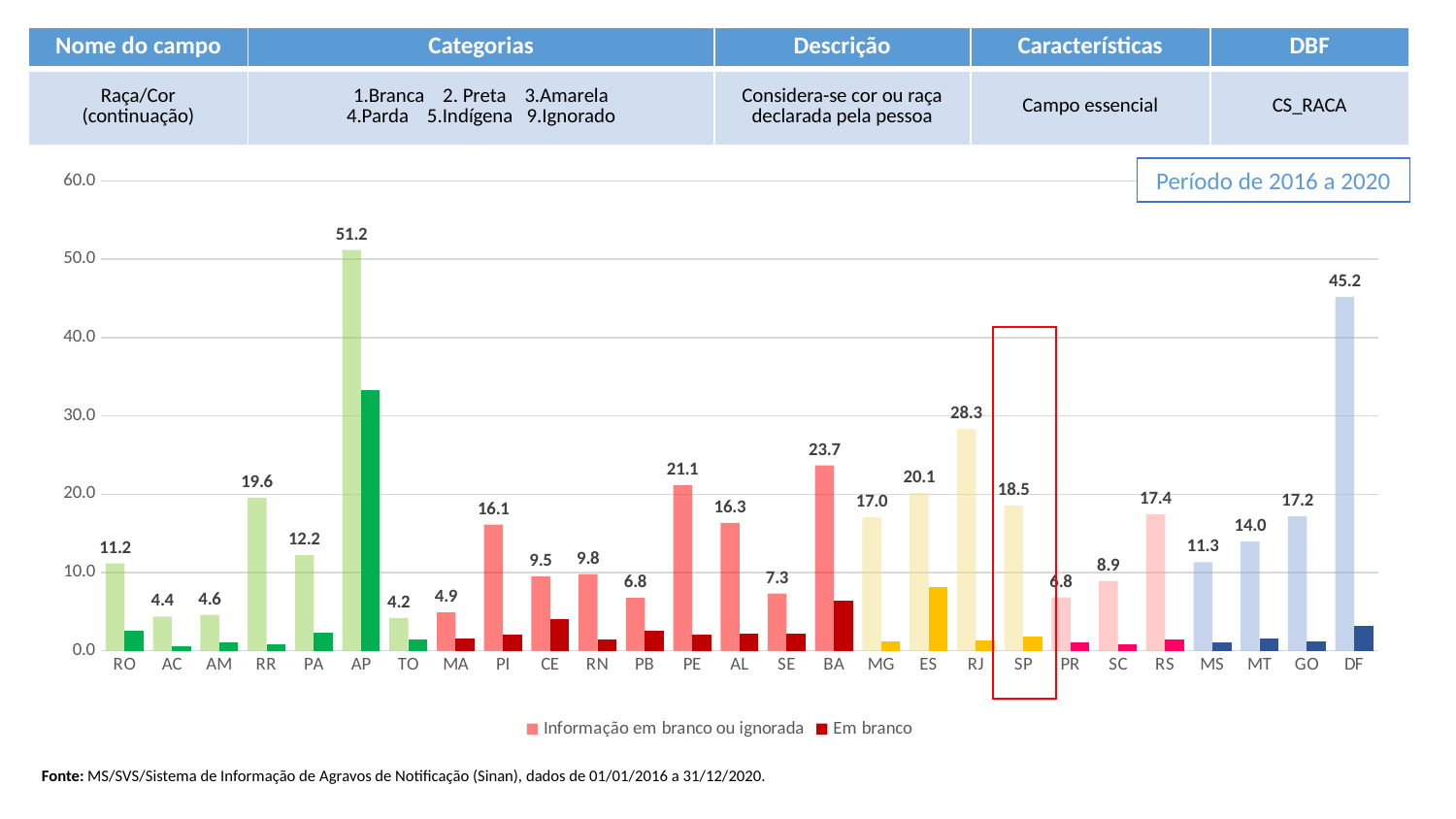
How many states are shown on the x axis of the chart? 27 Which has a larger "Informação em branco ou ignorada" value, BA or PE? BA What is the value of "Informação em branco ou ignorada" for AP? 51.2 What period does the chart cover, according to the box in the top right? Período de 2016 a 2020 What type of chart is shown on the slide? Bar chart What is the value of "Informação em branco ou ignorada" for DF? 45.2 What is the value of "Informação em branco ou ignorada" for SP? 18.5 What is the difference between the "Informação em branco ou ignorada" values for RJ and SP? 9.8 How many series does the chart legend list? 2 Which state has the lowest value for "Informação em branco ou ignorada"? TO Is the "Em branco" value for AP greater or less than 30.0? greater Which state has the highest value for "Informação em branco ou ignorada"? AP